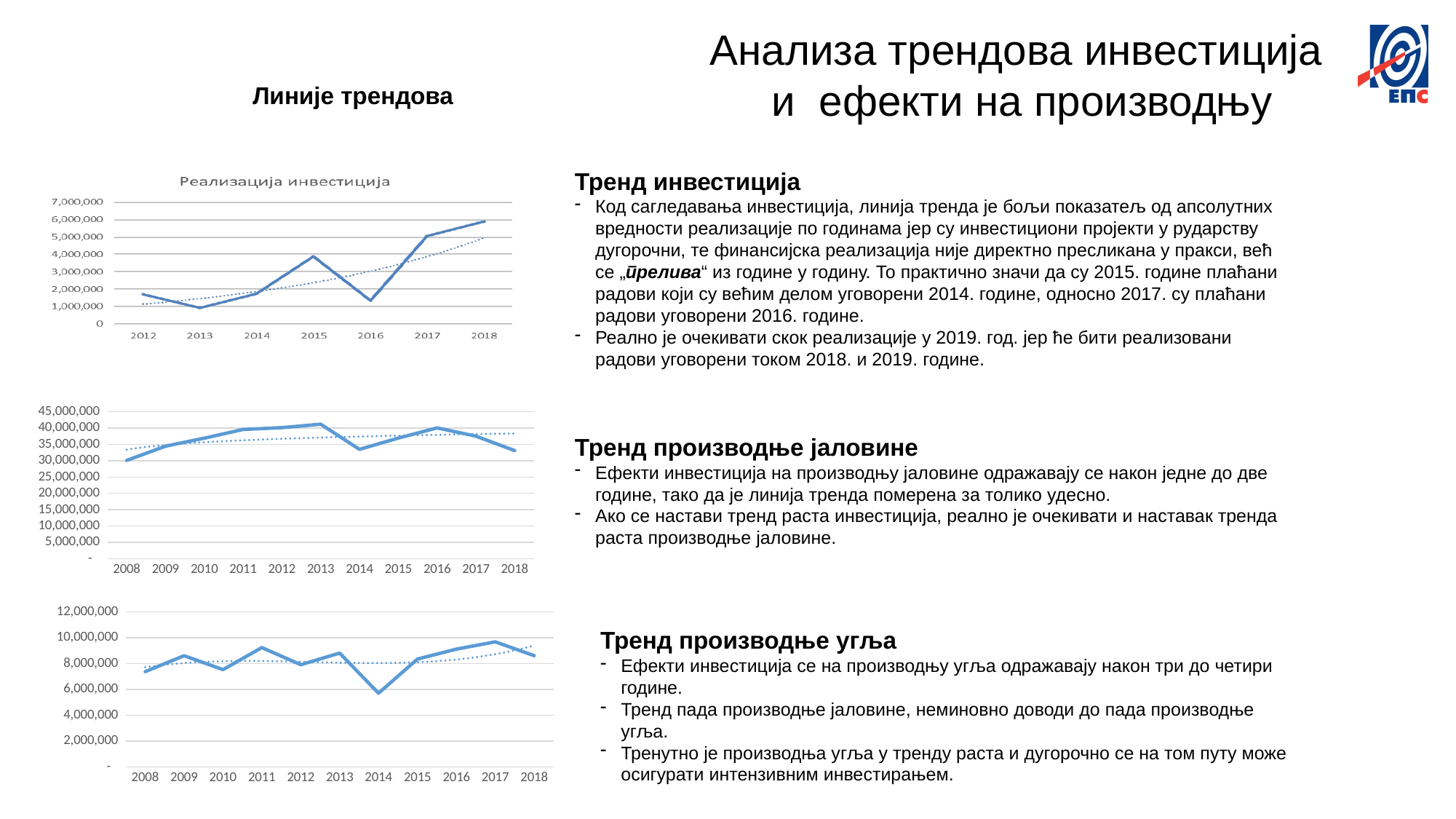
In the middle chart on the left, which year has the lowest value? 2008 In the middle chart on the left, is the value for 2013 greater or less than 40,000,000? greater How many years are plotted on the x axis of the bottom chart on the left? 11 In the top chart 'Реализација инвестиција', which year has the lowest value? 2013 In the middle chart on the left, which year has the highest value? 2013 In the top chart 'Реализација инвестиција', is the value for 2018 greater or less than 5,000,000? greater How many years are plotted on the x axis of the top chart 'Реализација инвестиција'? 7 In the top chart 'Реализација инвестиција', which year has the highest value? 2018 What kind of chart is the top chart titled 'Реализација инвестиција'? line chart In the bottom chart on the left, is the value for 2014 greater or less than 6,000,000? less In the bottom chart on the left, which year has the lowest value? 2014